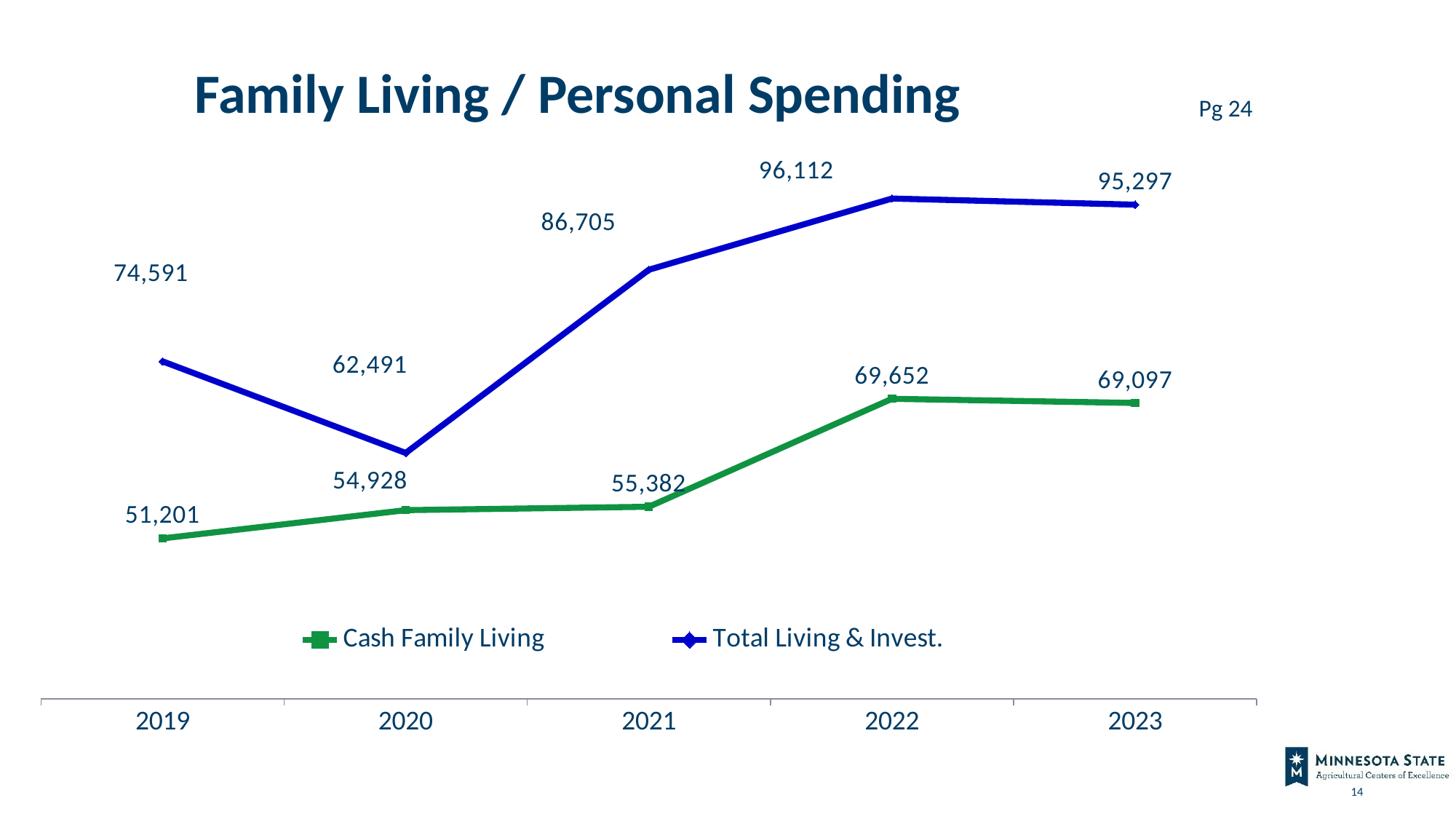
In which year is Total Living & Invest. highest? 2022 What is the value of Cash Family Living in 2019? 51,201 Which is larger in 2020: Cash Family Living or Total Living & Invest.? Total Living & Invest. How many series does the legend list? 2 What is the value of Total Living & Invest. in 2020? 62,491 What is the difference between Total Living & Invest. and Cash Family Living in 2021? 31,323 Does Cash Family Living rise or fall from 2019 to 2022? Rise What is the value of Cash Family Living in 2023? 69,097 In which year is Cash Family Living lowest? 2019 How many years are shown on the x axis? 5 What kind of chart is shown on the slide? Line chart What is the value of Total Living & Invest. in 2022? 96,112